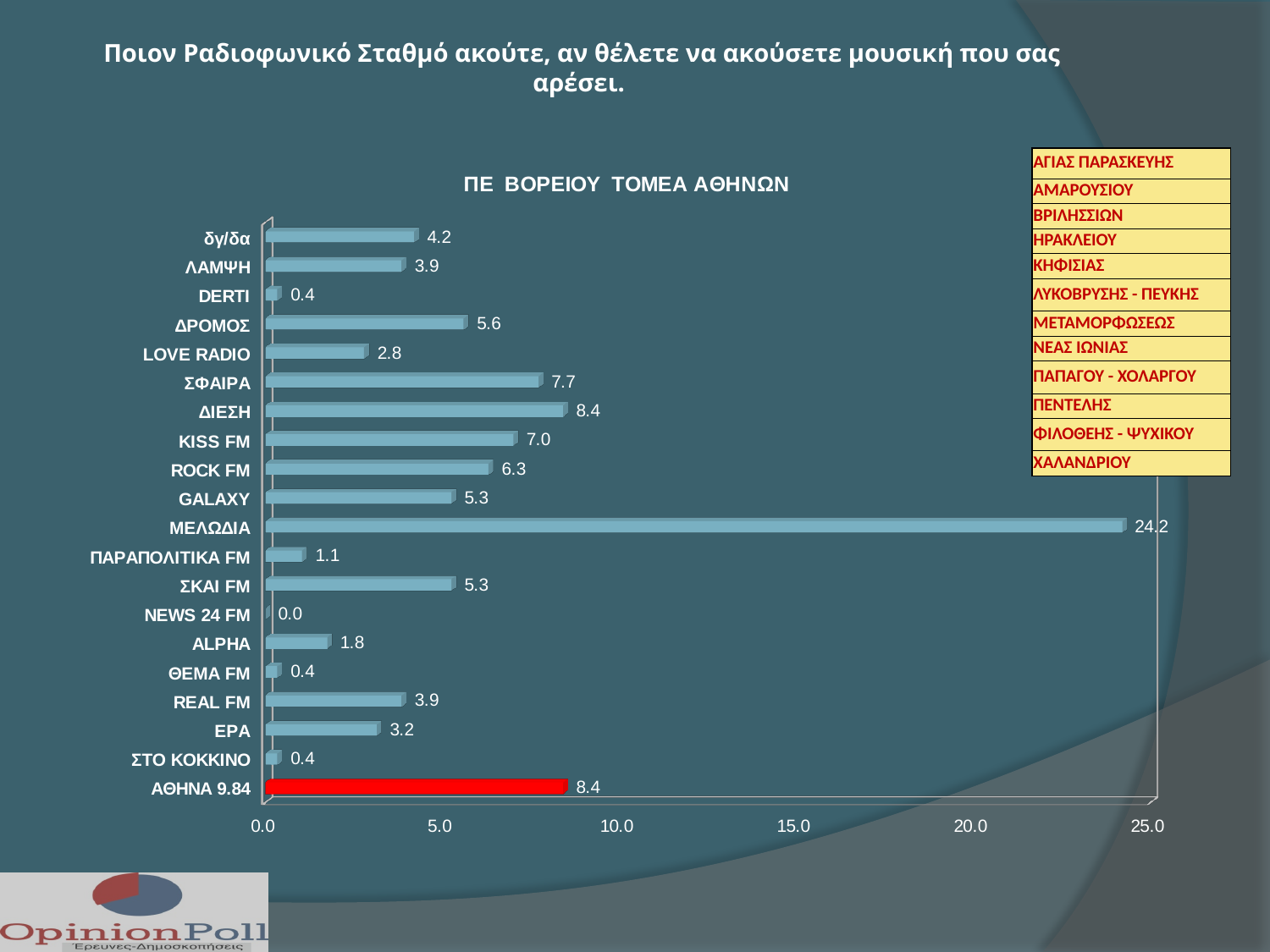
Which has a larger value, KISS FM or ROCK FM? KISS FM What is the value for ΜΕΛΩΔΙΑ in the chart? 24.2 What is the difference between the values for ΜΕΛΩΔΙΑ and ΔΙΕΣΗ? 15.8 What is the value for ΣΦΑΙΡΑ? 7.7 What is the title of the chart? ΠΕ ΒΟΡΕΙΟΥ ΤΟΜΕΑ ΑΘΗΝΩΝ Which radio station has the highest value in the chart? ΜΕΛΩΔΙΑ What kind of chart is shown on the slide? Bar chart Which radio station has the lowest value in the chart? NEWS 24 FM What is the value for ΑΘΗΝΑ 9.84? 8.4 Is the value for ΔΡΟΜΟΣ greater or less than 5.0? greater What is the value for LOVE RADIO? 2.8 How many radio stations (categories) are shown in the chart? 20